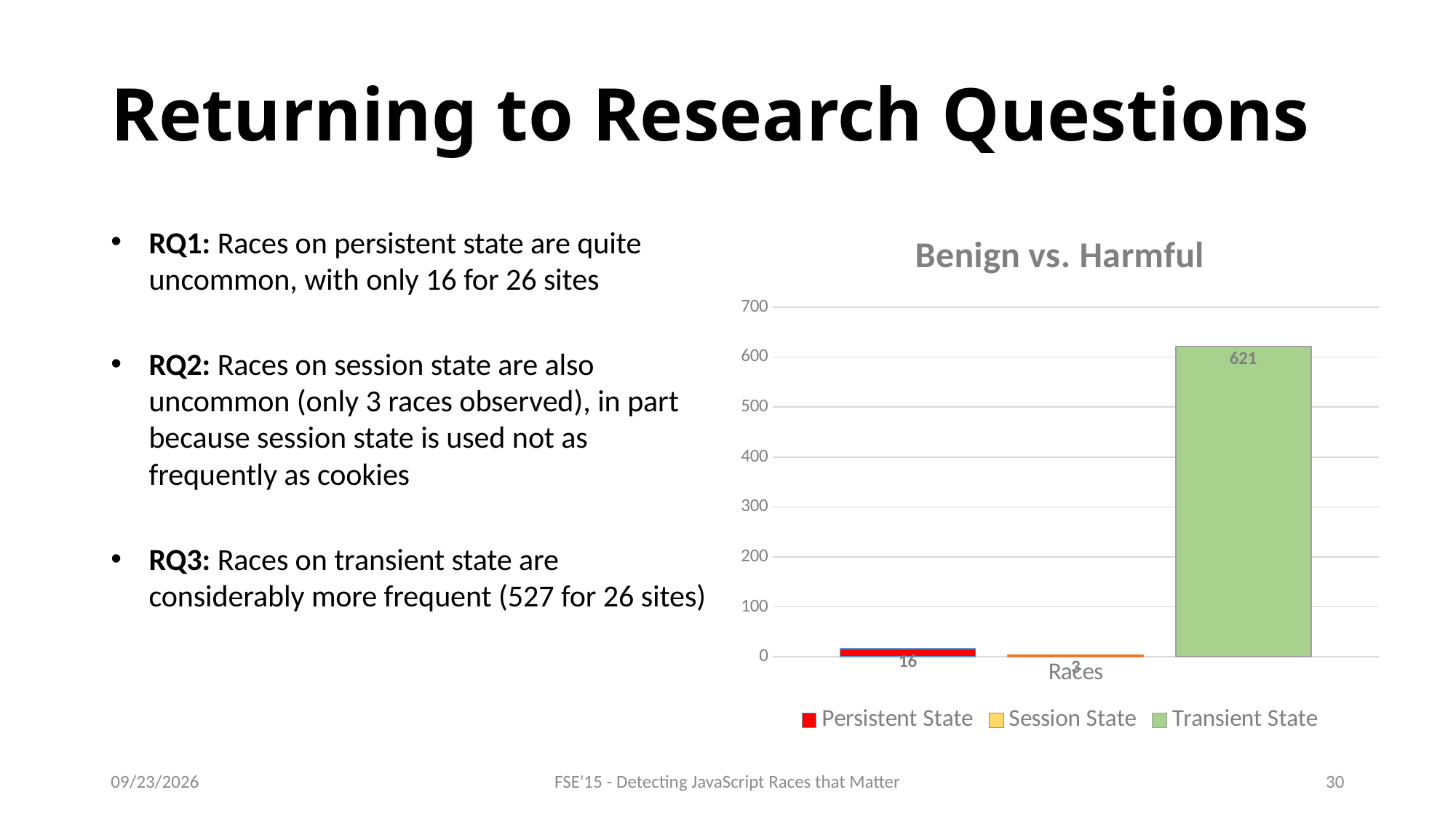
What is the value for Persistent State in the chart? 16 What is the title of the chart? Benign vs. Harmful Which is larger, the value for Persistent State or the value for Session State? Persistent State What is the value for Session State in the chart? 3 How many series does the chart legend list? 3 Which series has the highest value in the chart? Transient State Is the value for Transient State greater or less than 600? greater What is the value for Transient State in the chart? 621 What is the difference between the Transient State value and the Persistent State value? 605 Which series has the lowest value in the chart? Session State What type of chart is shown on the slide? bar chart What category label is shown on the x axis of the chart? Races